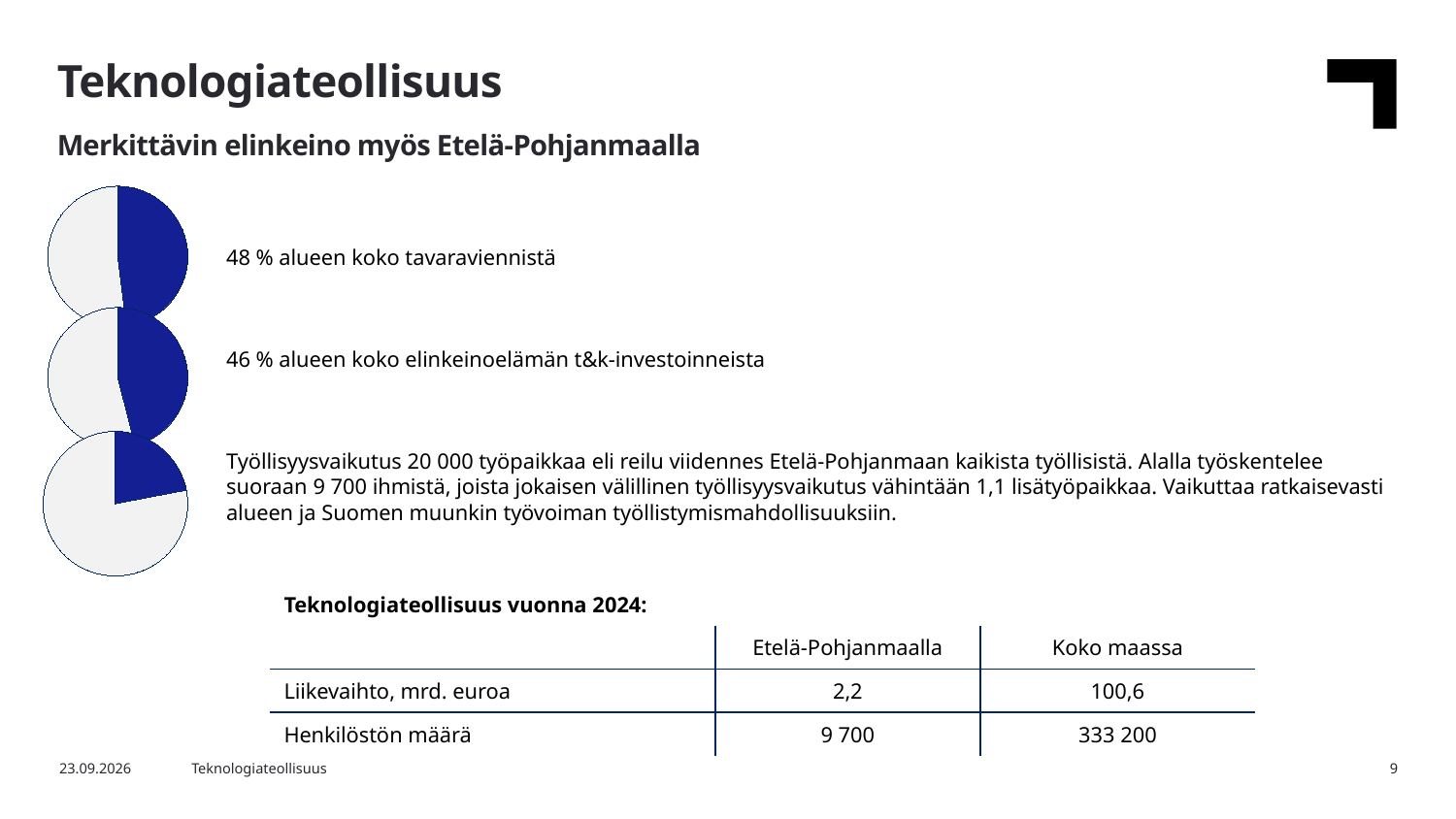
Which of the three pie charts has the smallest blue slice? the bottom pie chart Is the blue slice larger in the top pie chart or in the bottom pie chart? the top pie chart In the top pie chart, what share of the pie does the blue slice represent according to the text beside it? 48 % How many pie charts are shown on the slide? 3 What colour is the highlighted slice in the pie charts? blue According to the text next to the top pie chart, what does its blue slice represent? 48 % alueen koko tavaraviennistä What kind of chart is the top chart on the left of the slide? pie chart In the middle pie chart, what share of the pie does the blue slice represent according to the text beside it? 46 % How many slices does each pie chart have? 2